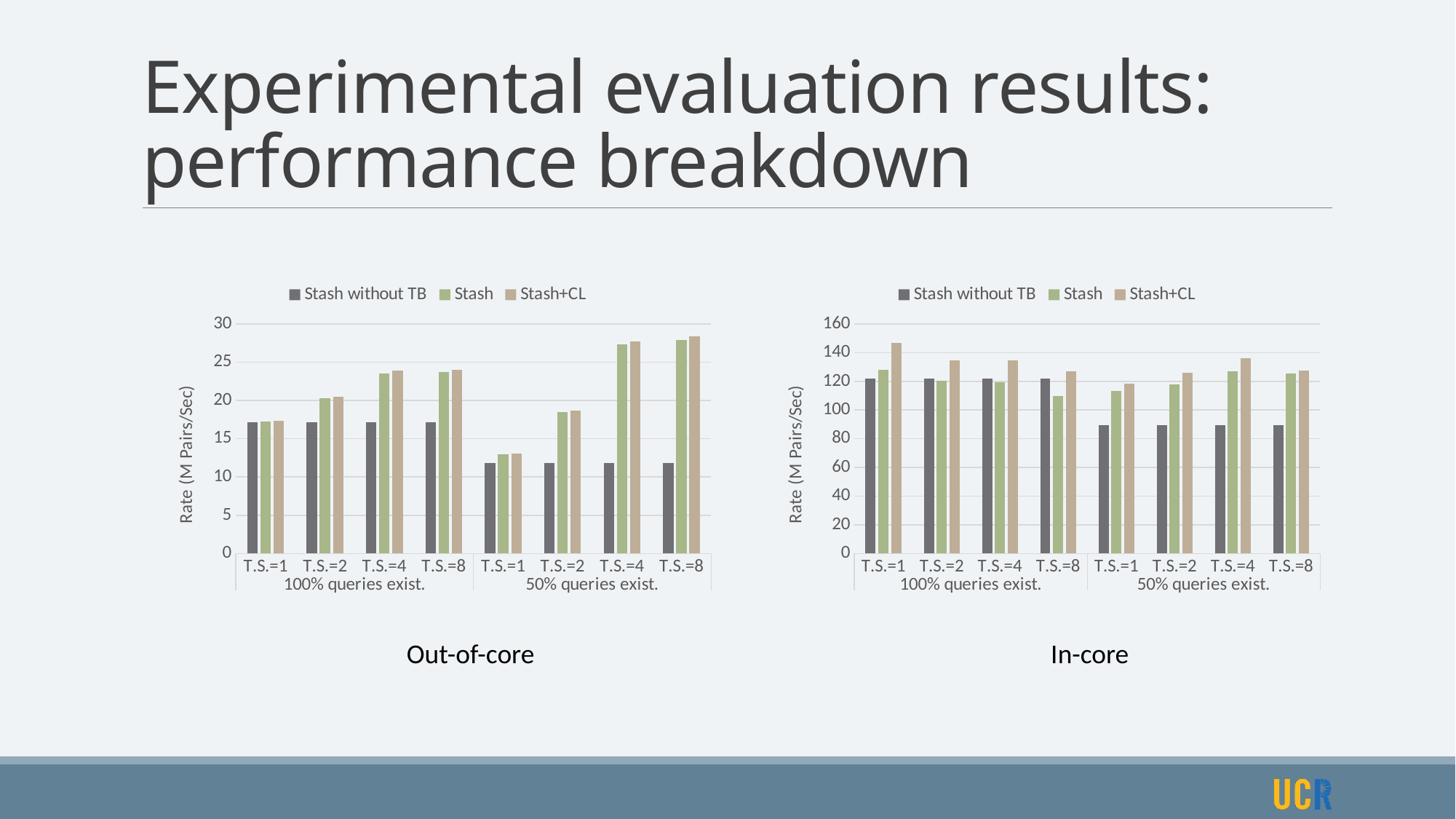
In the In-core chart, which category has the highest Stash+CL bar? T.S.=1 under 100% queries exist In the Out-of-core chart, is the Stash+CL value for T.S.=8 under 50% queries exist greater or less than 25? greater In the In-core chart, for T.S.=8 under 100% queries exist, which is larger: Stash or Stash without TB? Stash without TB In the In-core chart, is the Stash+CL value for T.S.=1 under 100% queries exist greater or less than 140? greater In the Out-of-core chart, do the Stash+CL values rise or fall from T.S.=1 to T.S.=8 under 50% queries exist? rise What is the y-axis label of the In-core chart? Rate (M Pairs/Sec) How many series does the legend of the In-core chart list? 3 In the In-core chart, is the Stash without TB value for T.S.=1 under 50% queries exist greater or less than 100? less How many T.S. categories are plotted along the x axis of the Out-of-core chart? 8 In the Out-of-core chart, for T.S.=4 under 100% queries exist, which is larger: Stash or Stash without TB? Stash What kind of chart is the Out-of-core chart on the left? bar chart